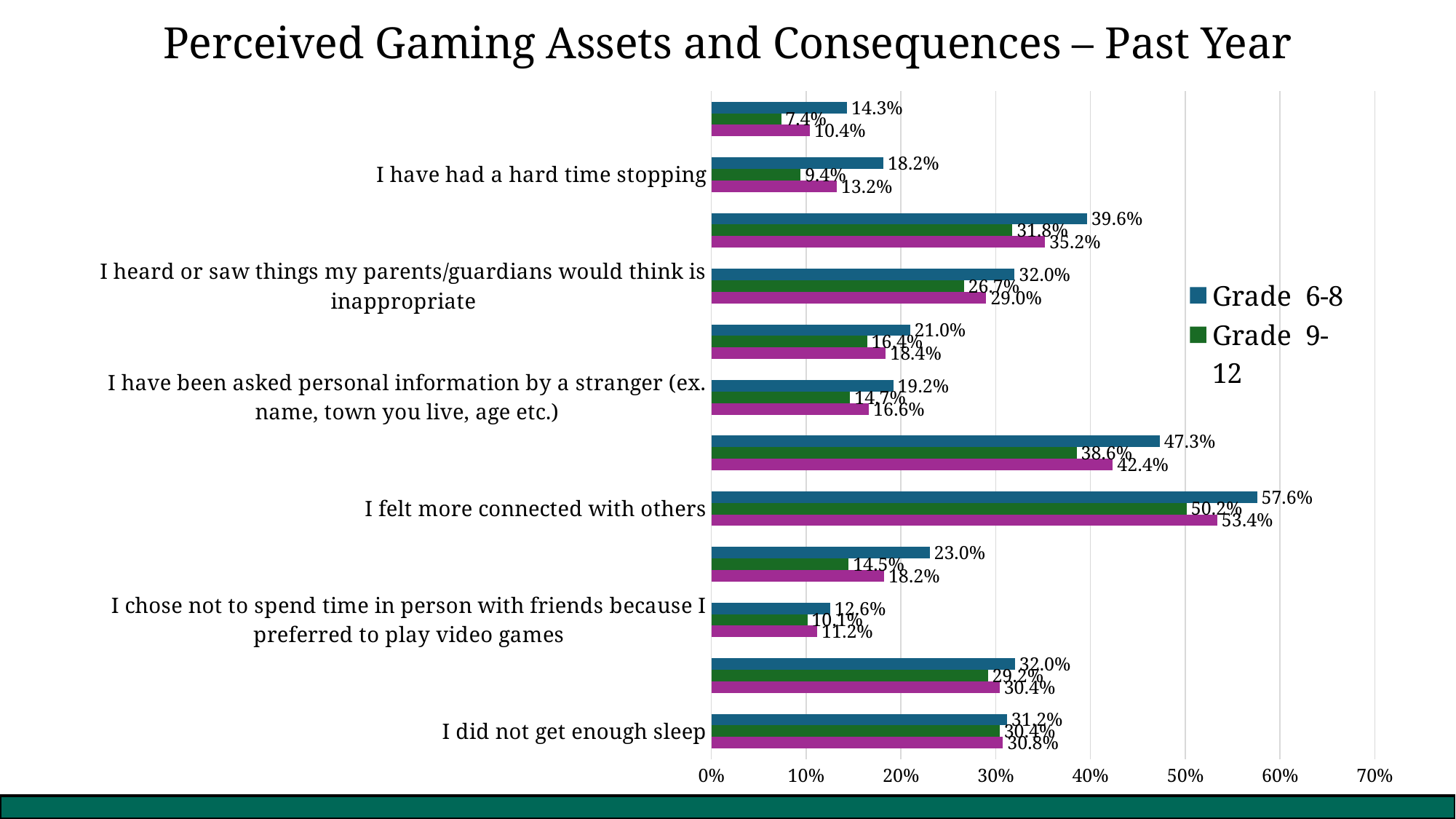
Which labeled category has the lowest Grade 9-12 value? I have had a hard time stopping Which is larger for "I did not get enough sleep": the Grade 6-8 value or the Grade 9-12 value? Grade 6-8 What is the Grade 6-8 value for "I did not get enough sleep"? 31.2% What is the difference between the Grade 6-8 and Grade 9-12 values for "I felt more connected with others"? 7.4% What is the Grade 6-8 value for "I chose not to spend time in person with friends because I preferred to play video games"? 12.6% What is the Grade 9-12 value for "I heard or saw things my parents/guardians would think is inappropriate"? 26.7% Which labeled category has the highest Grade 6-8 value? I felt more connected with others What is the difference between the Grade 6-8 and Grade 9-12 values for "I have been asked personal information by a stranger (ex. name, town you live, age etc.)"? 4.5% What kind of chart is shown on the slide? Bar chart What is the title of the chart? Perceived Gaming Assets and Consequences – Past Year What is the Grade 6-8 value for "I felt more connected with others"? 57.6% What is the Grade 9-12 value for "I have had a hard time stopping"? 9.4%